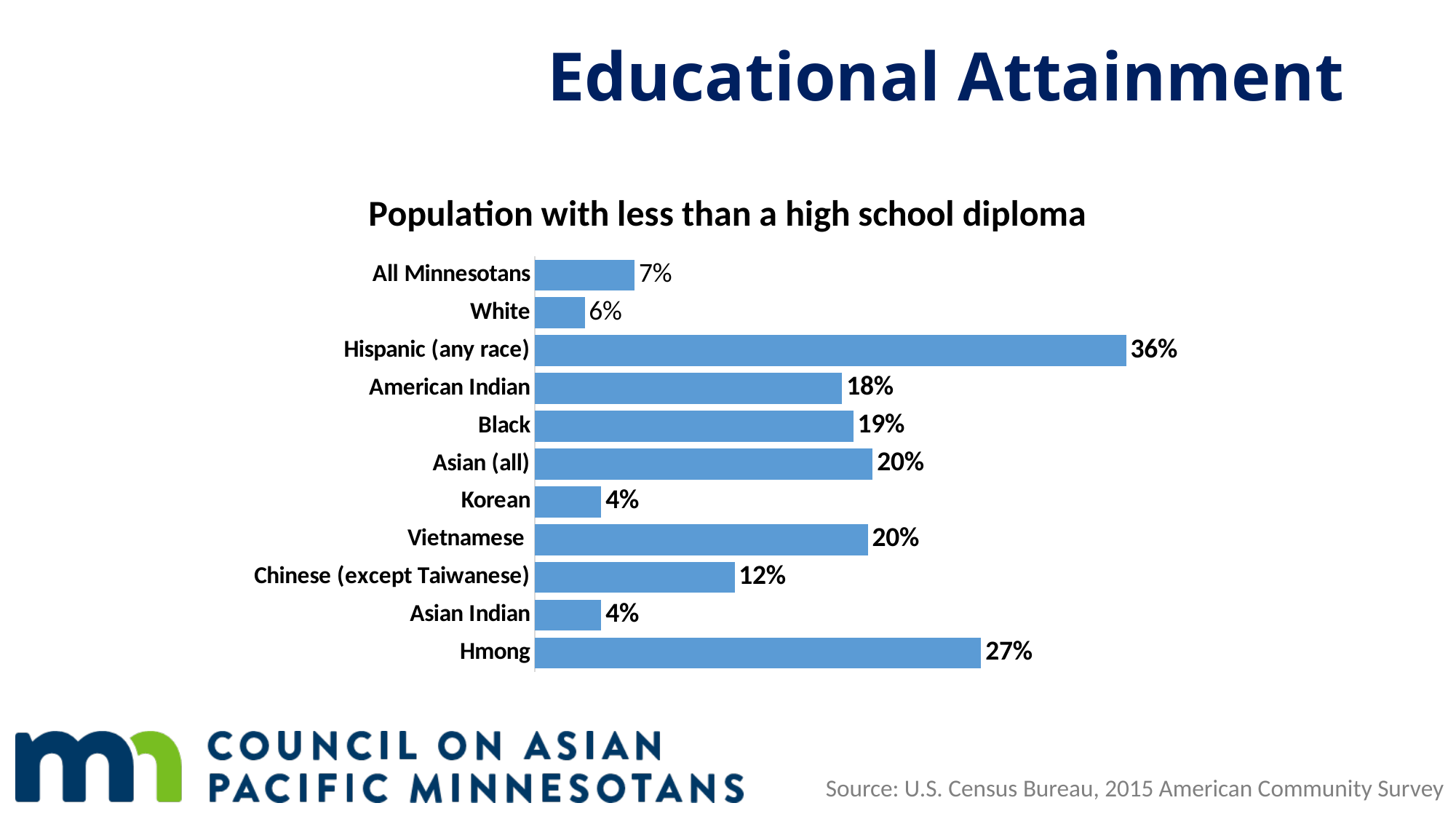
Which category has the highest percentage with less than a high school diploma? Hispanic (any race) What is the title of the chart? Population with less than a high school diploma What is the value for All Minnesotans? 7% Which is larger, the value for Black or the value for American Indian? Black What is the difference between the values for Asian (all) and White? 14% How many categories are shown in the chart? 11 What kind of chart is shown on the slide? Bar chart What is the difference between the values for Hispanic (any race) and Hmong? 9% What is the value for Chinese (except Taiwanese)? 12% What percentage of Hmong have less than a high school diploma? 27% Which is larger, the value for Vietnamese or the value for Chinese (except Taiwanese)? Vietnamese What is the source cited for the chart data? U.S. Census Bureau, 2015 American Community Survey